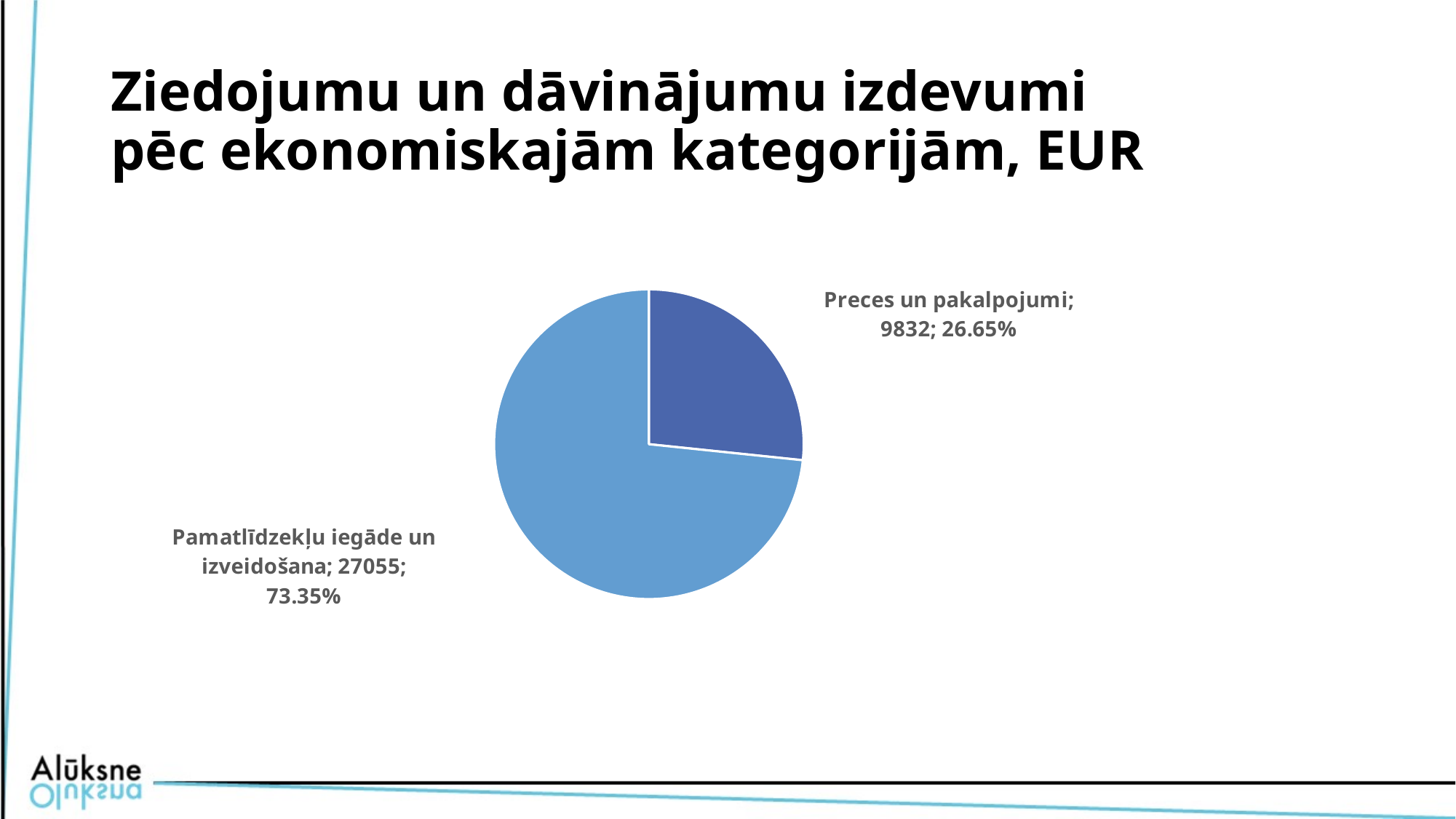
Which category has the smallest slice? Preces un pakalpojumi What is the value for Preces un pakalpojumi? 9832 What share of the pie does Preces un pakalpojumi represent? 26.65% Which is larger, the value for Preces un pakalpojumi or the value for Pamatlīdzekļu iegāde un izveidošana? Pamatlīdzekļu iegāde un izveidošana What is the value for Pamatlīdzekļu iegāde un izveidošana? 27055 What kind of chart is shown on the slide? pie chart What share of the pie does Pamatlīdzekļu iegāde un izveidošana represent? 73.35% What is the title of the chart on the slide? Ziedojumu un dāvinājumu izdevumi pēc ekonomiskajām kategorijām, EUR How many slices does the pie chart have? 2 What is the total of the two slices in the pie chart? 36887 Which category has the largest slice? Pamatlīdzekļu iegāde un izveidošana What is the difference between the values for Pamatlīdzekļu iegāde un izveidošana and Preces un pakalpojumi? 17223